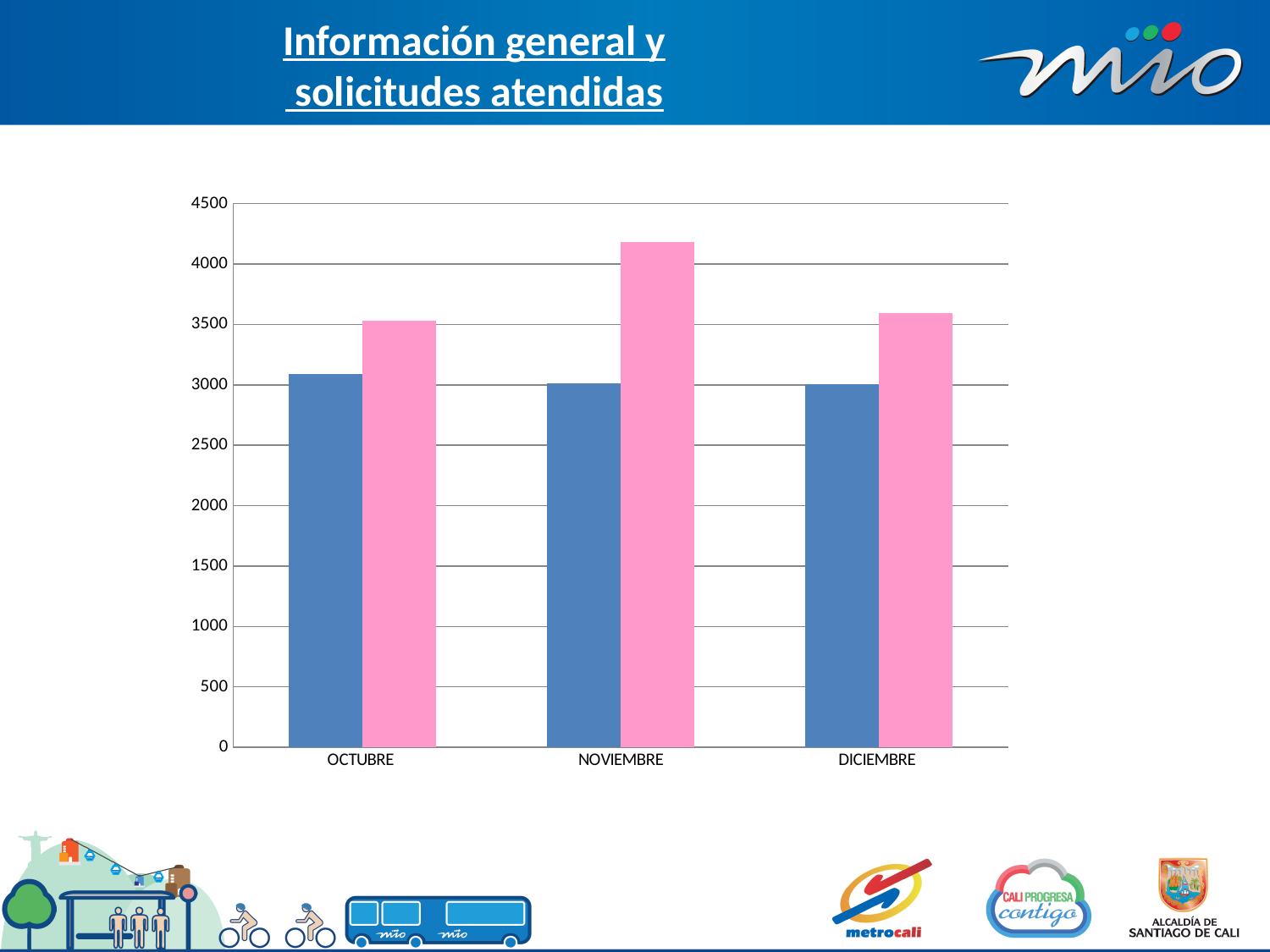
Which pink bar is taller, NOVIEMBRE or DICIEMBRE? NOVIEMBRE What colours are the two bar series in the chart? blue and pink In NOVIEMBRE, which bar is taller, the blue one or the pink one? the pink one Is the blue bar for NOVIEMBRE greater or less than 3500? less Is the pink bar for OCTUBRE greater or less than 4000? less Is the blue bar for OCTUBRE greater or less than 3000? greater What kind of chart is shown on the slide? bar chart How many bars are shown for each month? 2 Which month has the tallest pink bar? NOVIEMBRE How many categories (months) are shown on the x axis? 3